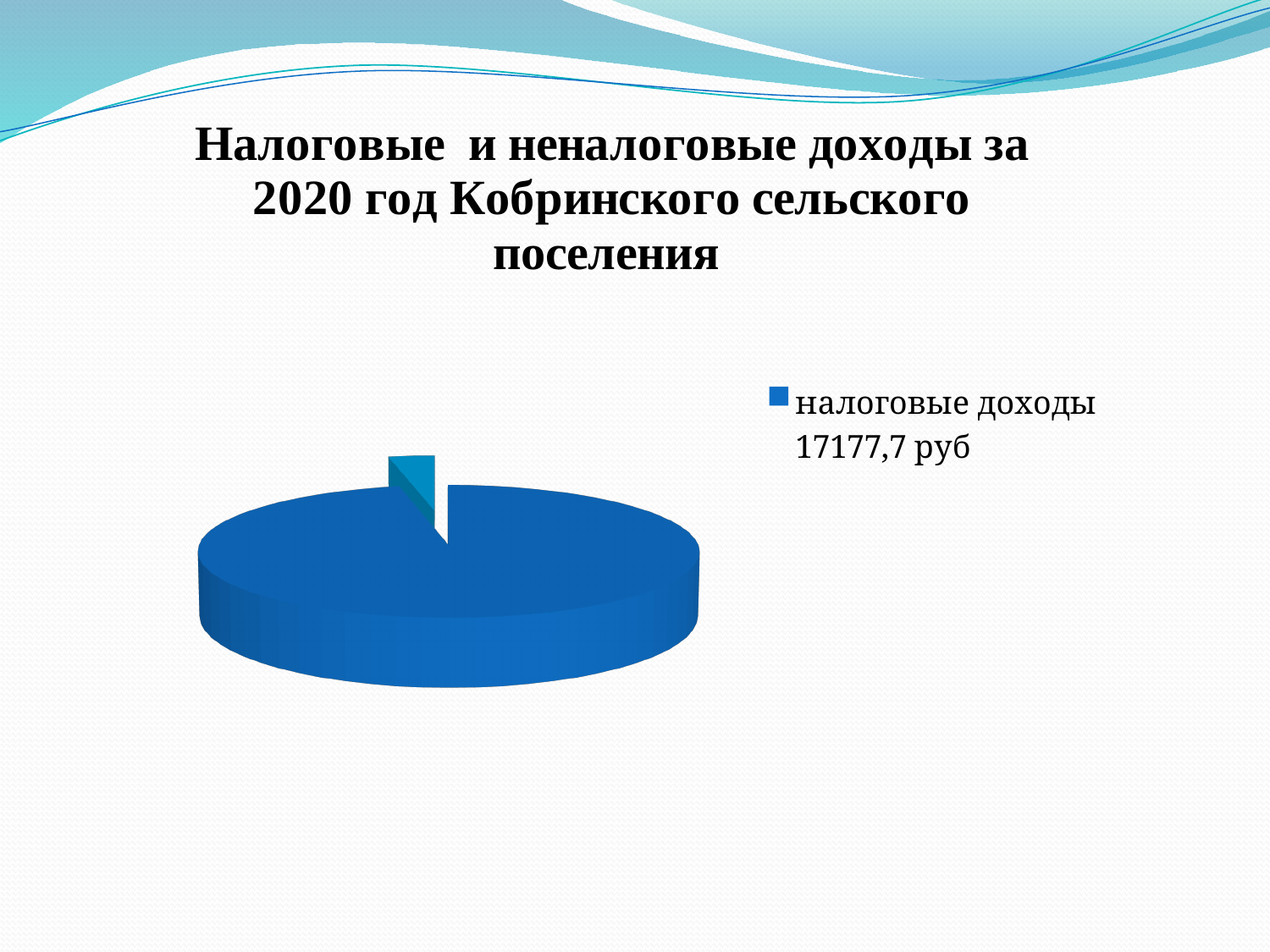
Which year does the chart title refer to? 2020 Which category takes up the largest share of the pie chart? налоговые доходы How many slices does the pie chart have? 2 How many entries does the chart legend list? 1 What value is given for налоговые доходы in the chart legend? 17177,7 руб What is the title of the chart slide? Налоговые и неналоговые доходы за 2020 год Кобринского сельского поселения What kind of chart is shown on the slide? pie chart What colour is the slice for налоговые доходы? blue